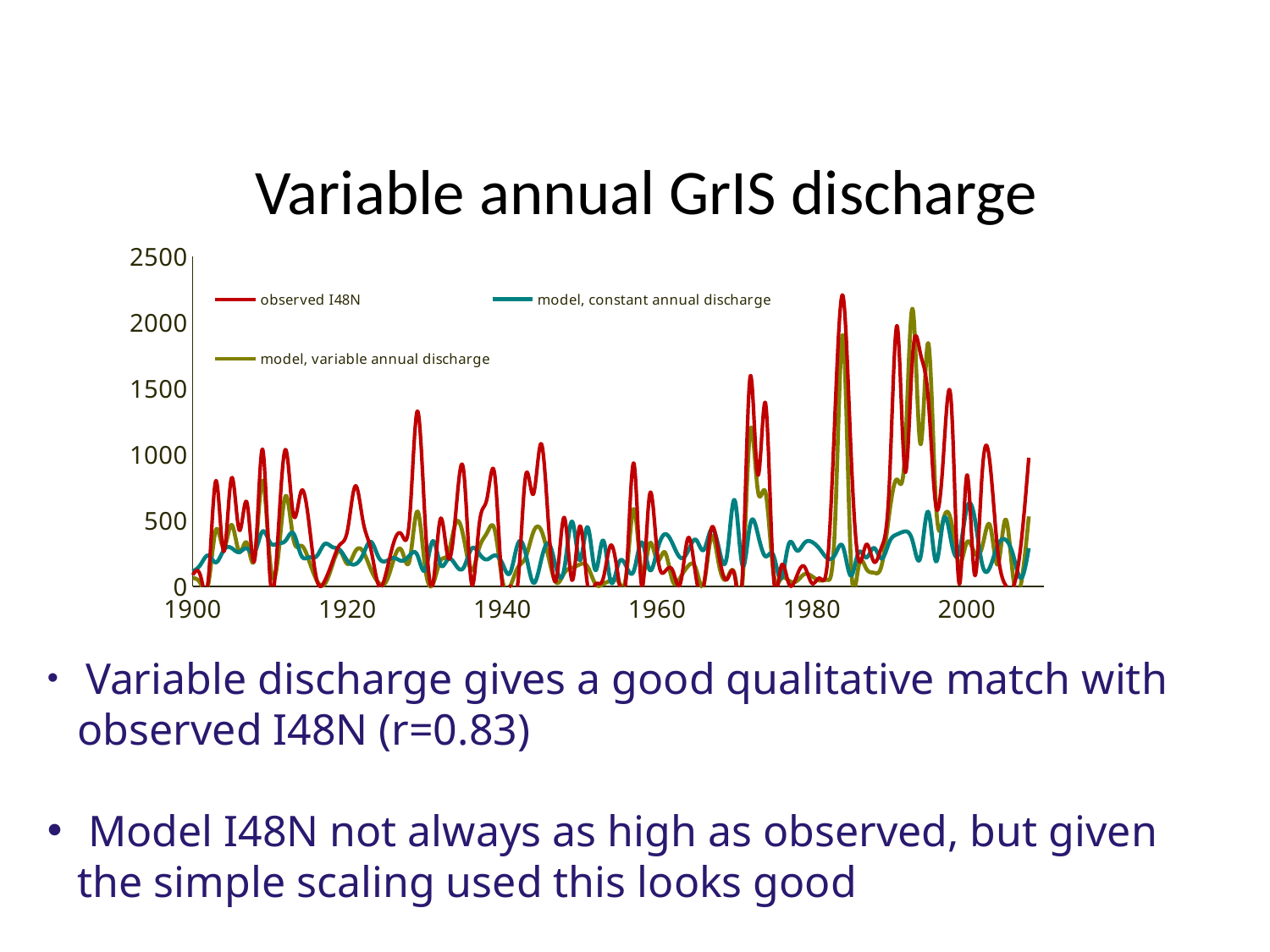
Which colour is used for the observed I48N series? red What is the first year shown on the x axis? 1900 Which series never rises above 1000 anywhere on the chart? model, constant annual discharge Around 1984, which series is larger: observed I48N or model, constant annual discharge? observed I48N How many series does the legend list? 3 What is the title of the chart? Variable annual GrIS discharge Is the observed I48N peak around 1929 greater or less than 1000? greater Is the value of the model, variable annual discharge series at its peak around 1984 greater or less than 1500? greater What kind of chart is shown on the slide? line chart Is the peak of the observed I48N series around 1984 greater or less than 2000? greater What is the highest value shown on the y axis? 2500